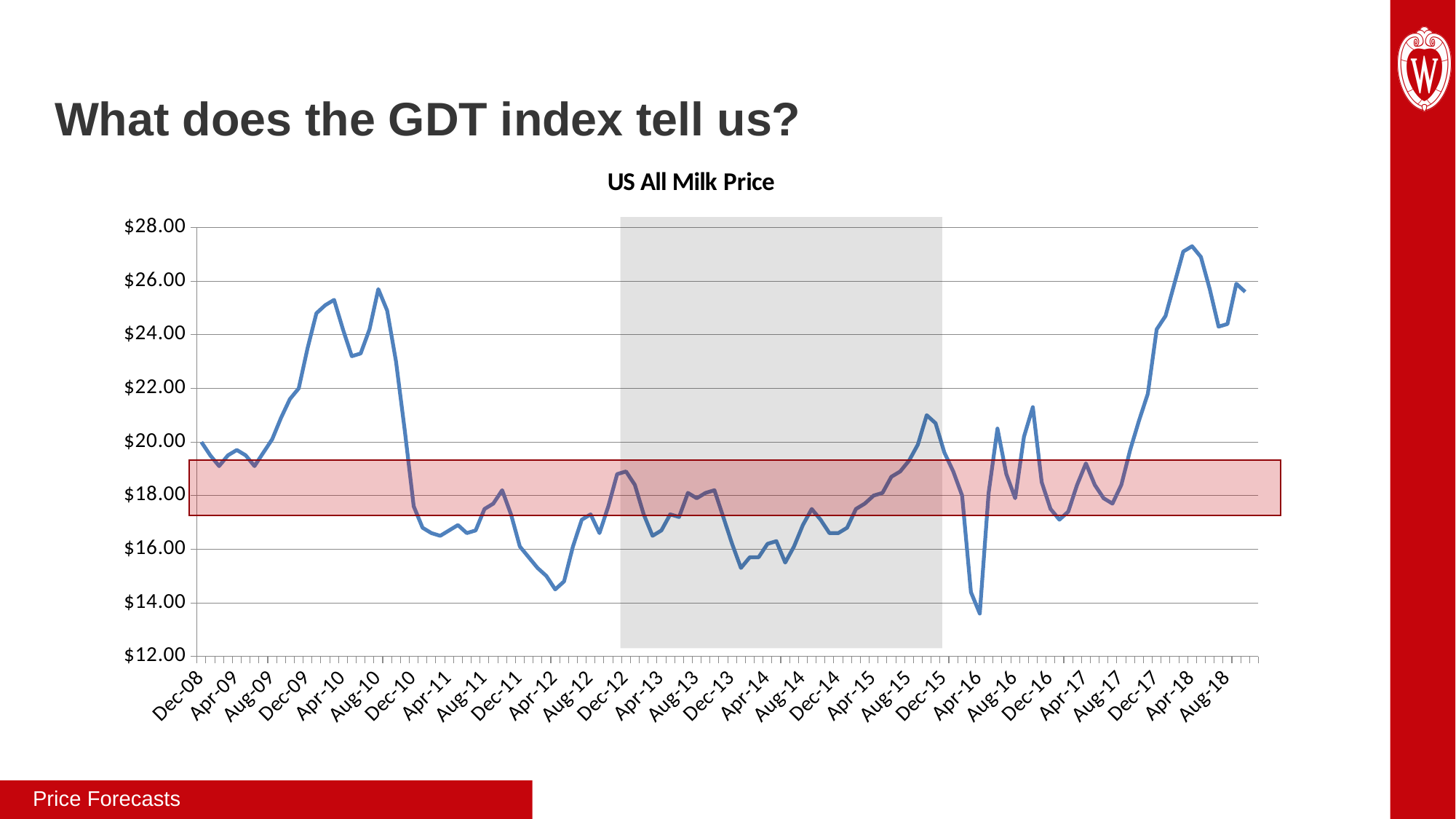
Which is larger, the value for Apr-10 or the value for Apr-12? Apr-10 Is the lowest point on the line greater or less than $14.00? less What kind of chart is shown on the slide? line chart Is the value for Apr-12 greater or less than $16.00? less What is the title of the chart? US All Milk Price Is the highest point on the line greater or less than $26.00? greater Does the line rise or fall between Aug-17 and Apr-18? rise Does the line rise or fall between Dec-10 and Apr-12? fall What is the highest value shown on the y axis of the chart? $28.00